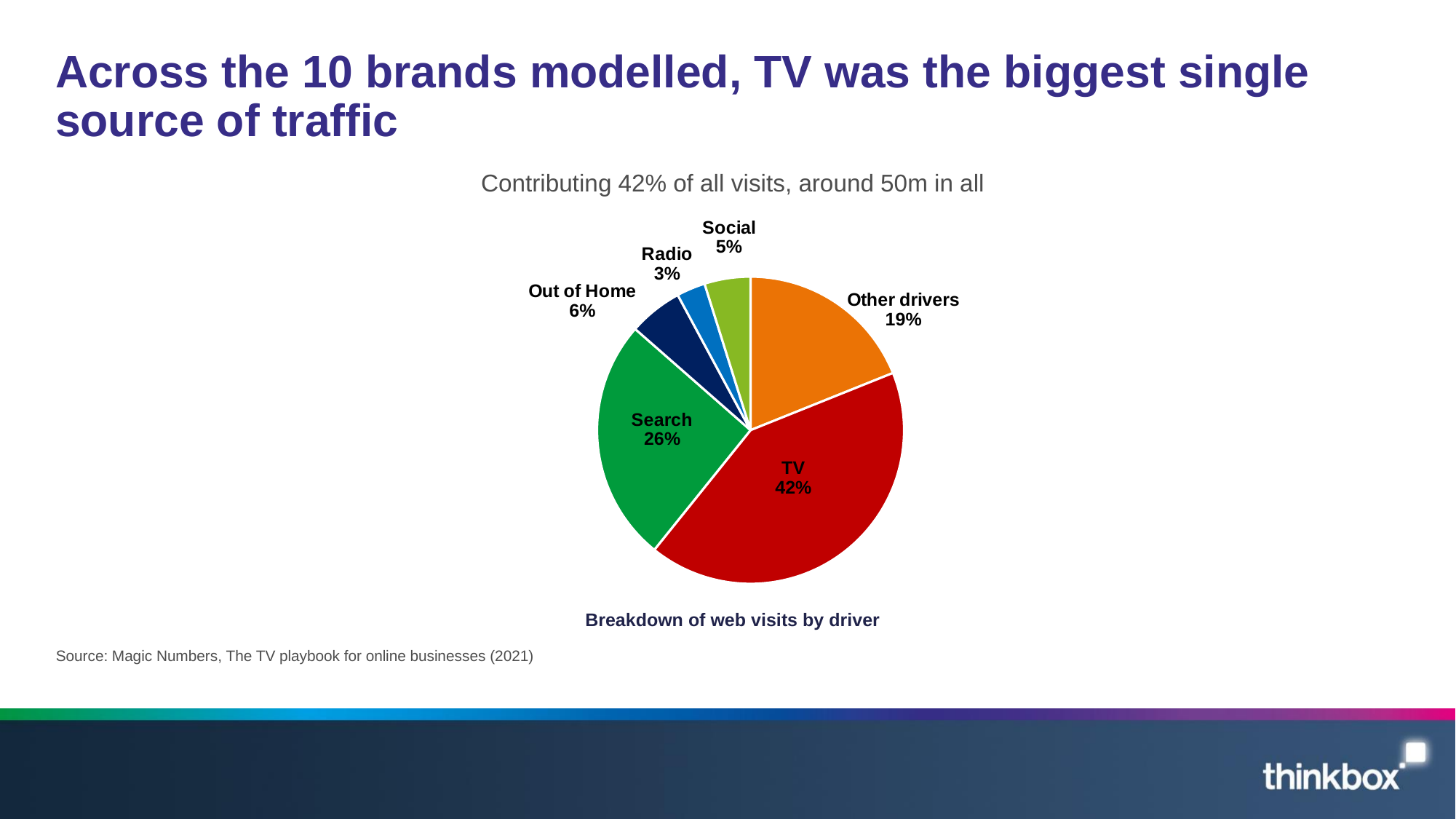
What share of web visits is attributed to Other drivers? 19% What share of web visits does Radio account for? 3% What is the title printed below the chart? Breakdown of web visits by driver How many drivers (slices) are shown in the pie chart? 6 Which driver has the largest share of web visits? TV Which has a larger share of web visits, Out of Home or Social? Out of Home What kind of chart is shown on the slide? Pie chart What share of web visits does TV account for? 42% What is the difference in percentage points between the TV share and the Search share? 16 What share of web visits does Search account for? 26% What colour is the TV slice of the pie chart? Red Which driver has the smallest share of web visits? Radio